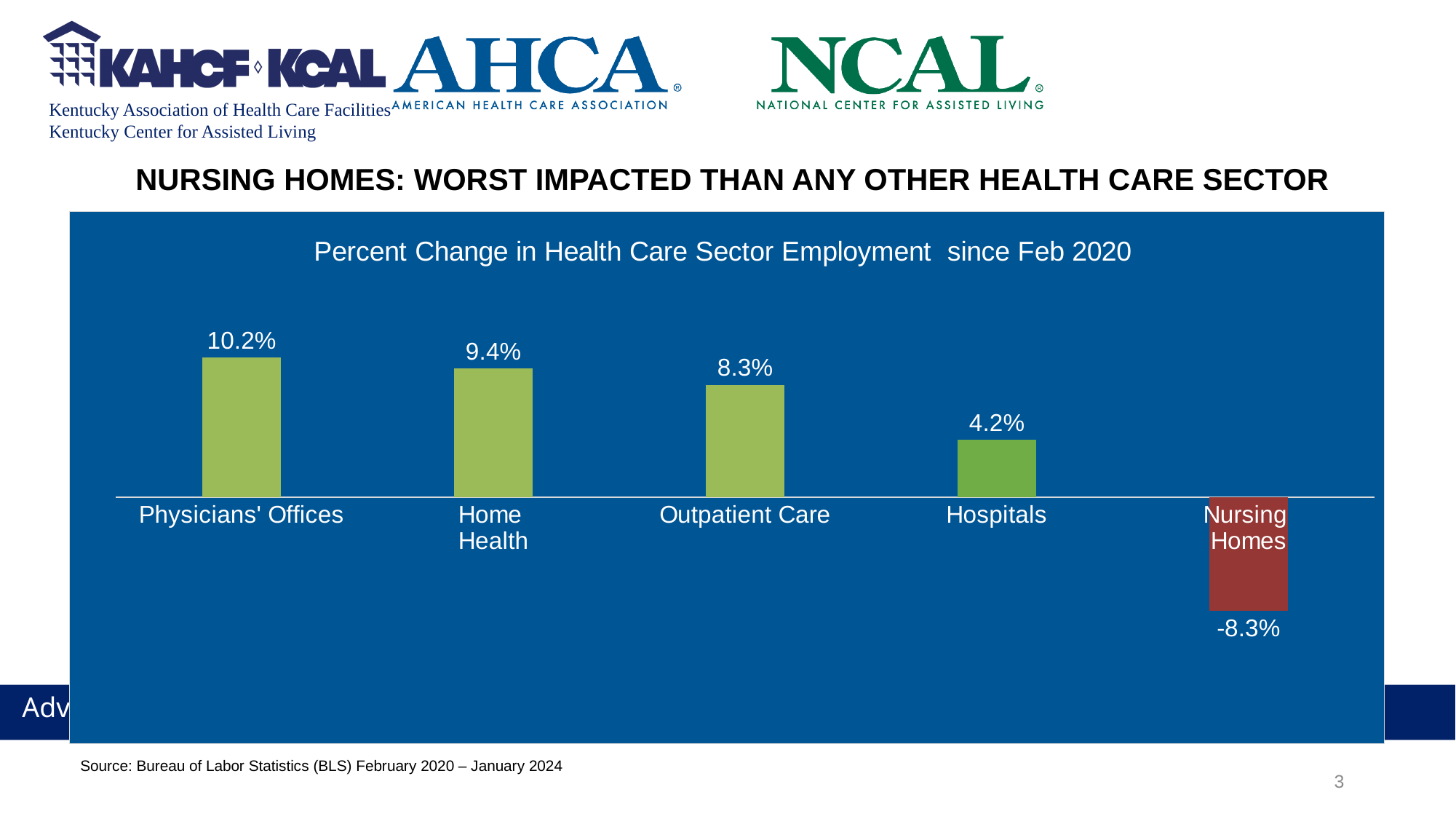
What is the percent change in employment for Nursing Homes? -8.3% Which sector has the highest percent change in employment? Physicians' Offices Do the values rise or fall moving from left to right across the sectors? Fall How many health care sectors are shown in the chart? 5 What is the percent change in employment for Hospitals? 4.2% Which sector has the lowest percent change in employment? Nursing Homes What is the title of the chart? Percent Change in Health Care Sector Employment since Feb 2020 What kind of chart is shown on the slide? Bar chart What is the percent change in employment for Physicians' Offices? 10.2% What is the difference between the percent change for Outpatient Care and Hospitals? 4.1% What is the percent change in employment for Home Health? 9.4% Which has a larger percent change in employment, Home Health or Outpatient Care? Home Health